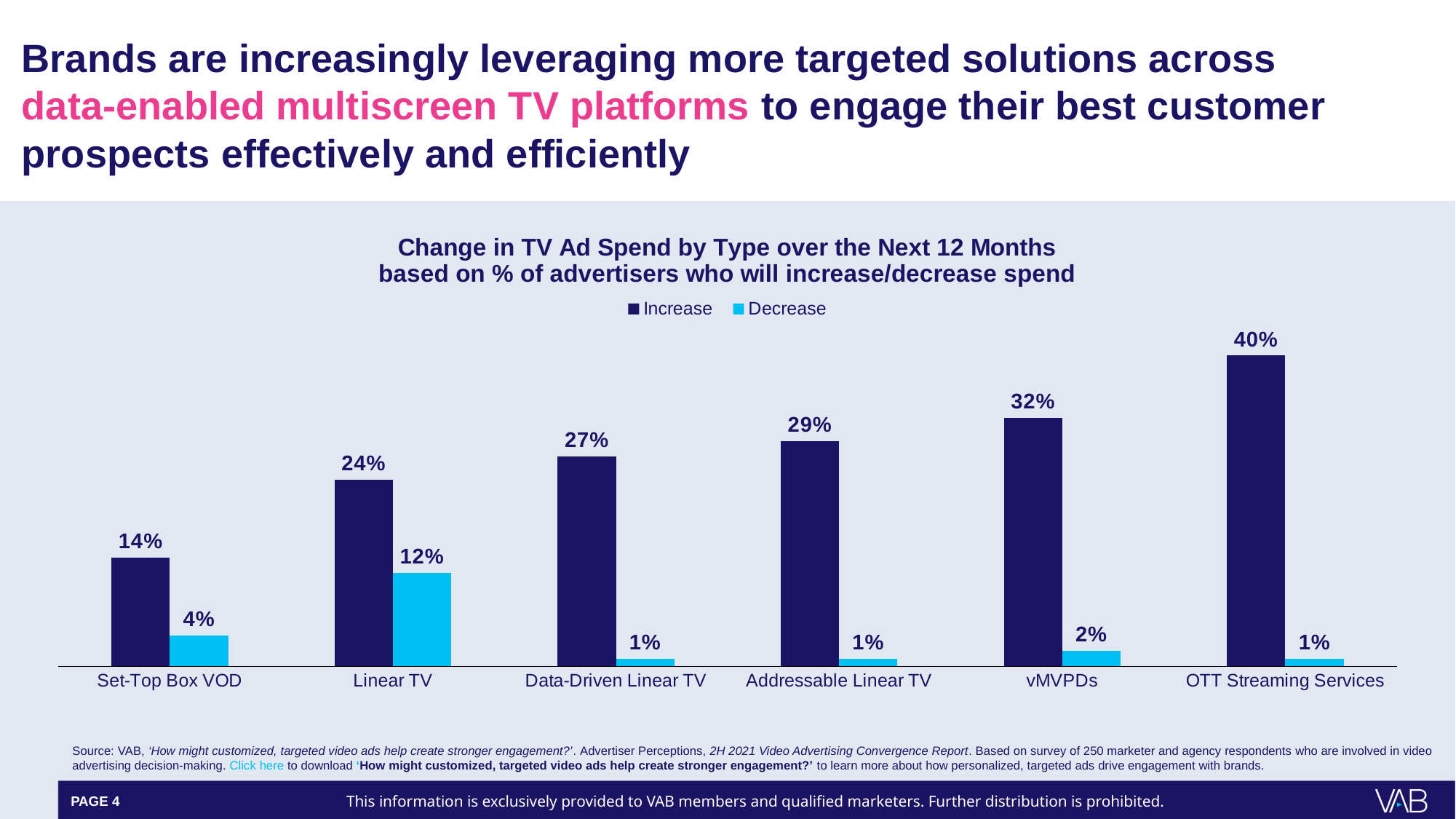
What percentage of advertisers will increase spend on OTT Streaming Services? 40% What type of chart is shown on the slide? Bar chart How many series does the legend list? 2 What is the Decrease value for Linear TV? 12% What is the Increase value for Addressable Linear TV? 29% Which has a larger Increase value, Data-Driven Linear TV or Linear TV? Data-Driven Linear TV Which category has the highest Increase value? OTT Streaming Services How much higher is the Increase value for OTT Streaming Services than for vMVPDs? 8% How many categories are shown on the x axis? 6 Which category has the lowest Increase value? Set-Top Box VOD What is the difference between the Increase and Decrease values for Set-Top Box VOD? 10% Which category has the highest Decrease value? Linear TV